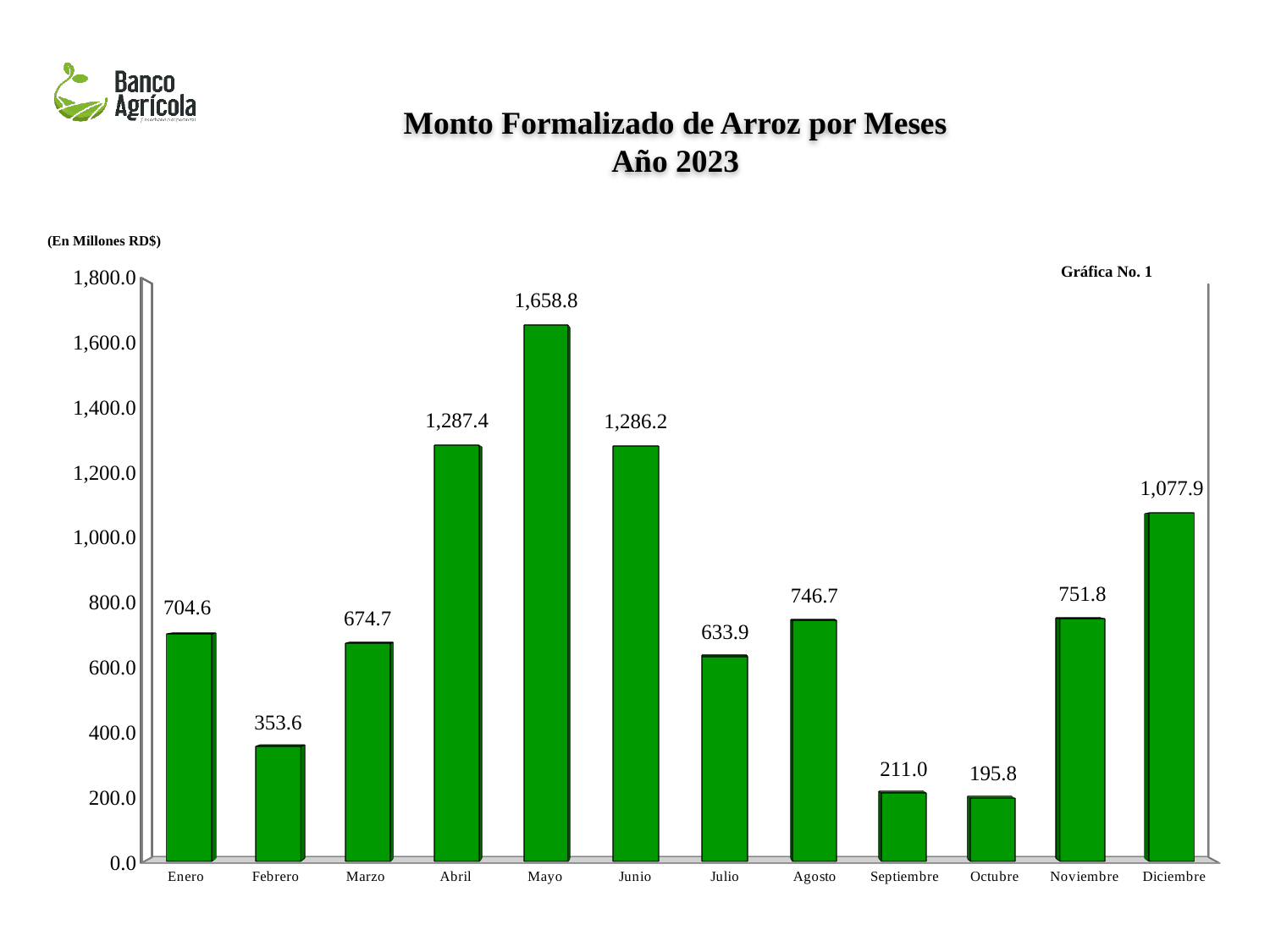
What unit is stated for the values in the chart? En Millones RD$ What is the value for Mayo? 1,658.8 What is the value for Octubre? 195.8 Which month has the lowest value? Octubre Is the value for Diciembre greater or less than 1,000.0? greater What kind of chart is shown on the slide? Bar chart What is the difference between the values for Diciembre and Noviembre? 326.1 Which is larger, the value for Febrero or the value for Julio? Julio How many months are shown on the x axis? 12 What is the value for Diciembre? 1,077.9 What is the difference between the values for Mayo and Abril? 371.4 Which month has the highest value? Mayo